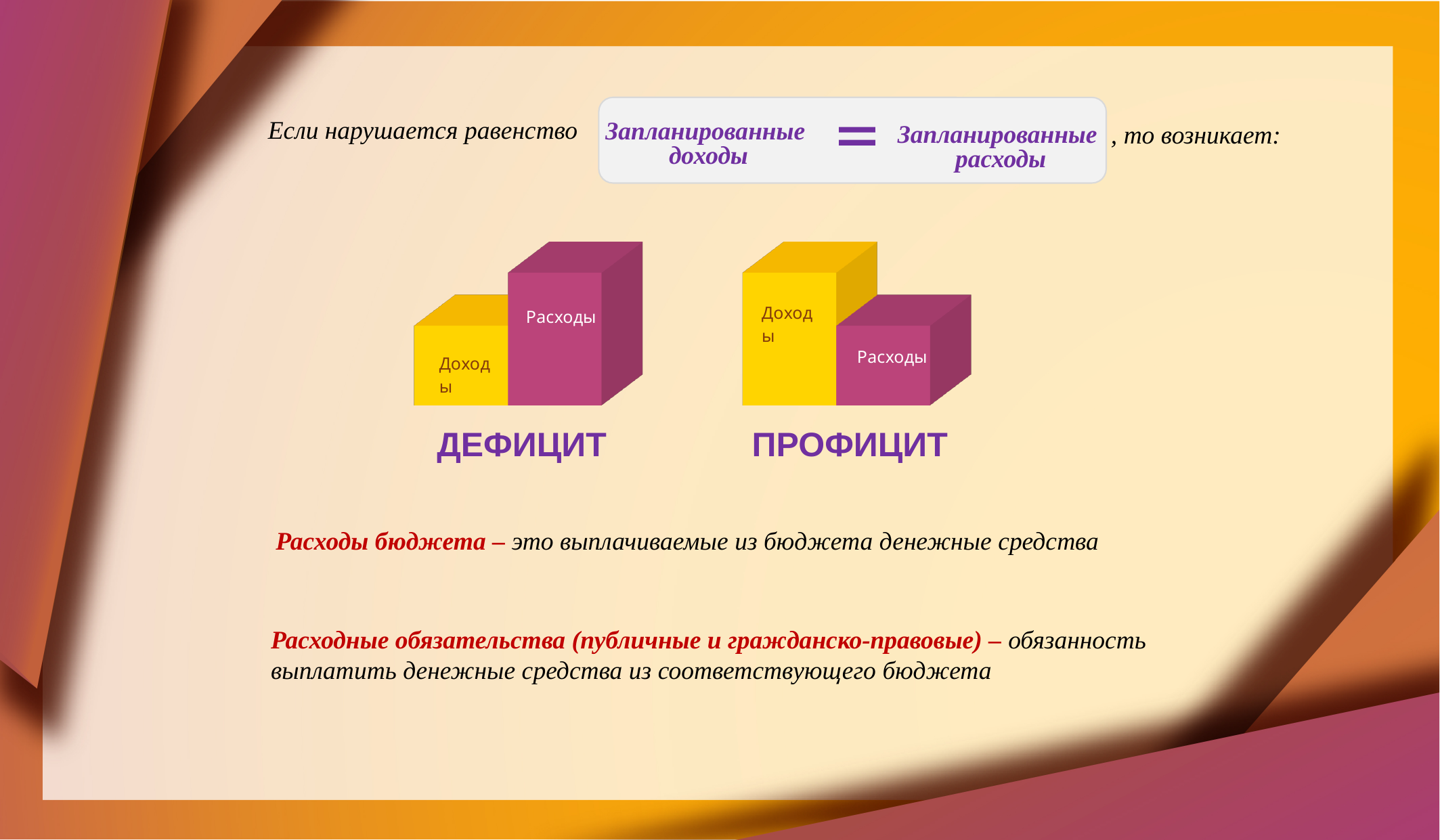
In the ПРОФИЦИТ chart, which category has the highest bar? Доходы In the ДЕФИЦИТ chart, which bar is taller, Доходы or Расходы? Расходы In the ДЕФИЦИТ chart, which category has the lowest bar? Доходы In the ДЕФИЦИТ chart, which category has the highest bar? Расходы In the ДЕФИЦИТ chart, what colour is the Доходы bar? yellow In the ПРОФИЦИТ chart, which category has the lowest bar? Расходы In the ПРОФИЦИТ chart, which bar is taller, Доходы or Расходы? Доходы In the ДЕФИЦИТ chart, how many bars are plotted? 2 In the ПРОФИЦИТ chart, what colour is the Расходы bar? magenta What kind of chart is shown under the label ДЕФИЦИТ? bar chart In the ПРОФИЦИТ chart, how many bars are plotted? 2 What kind of chart is shown under the label ПРОФИЦИТ? bar chart